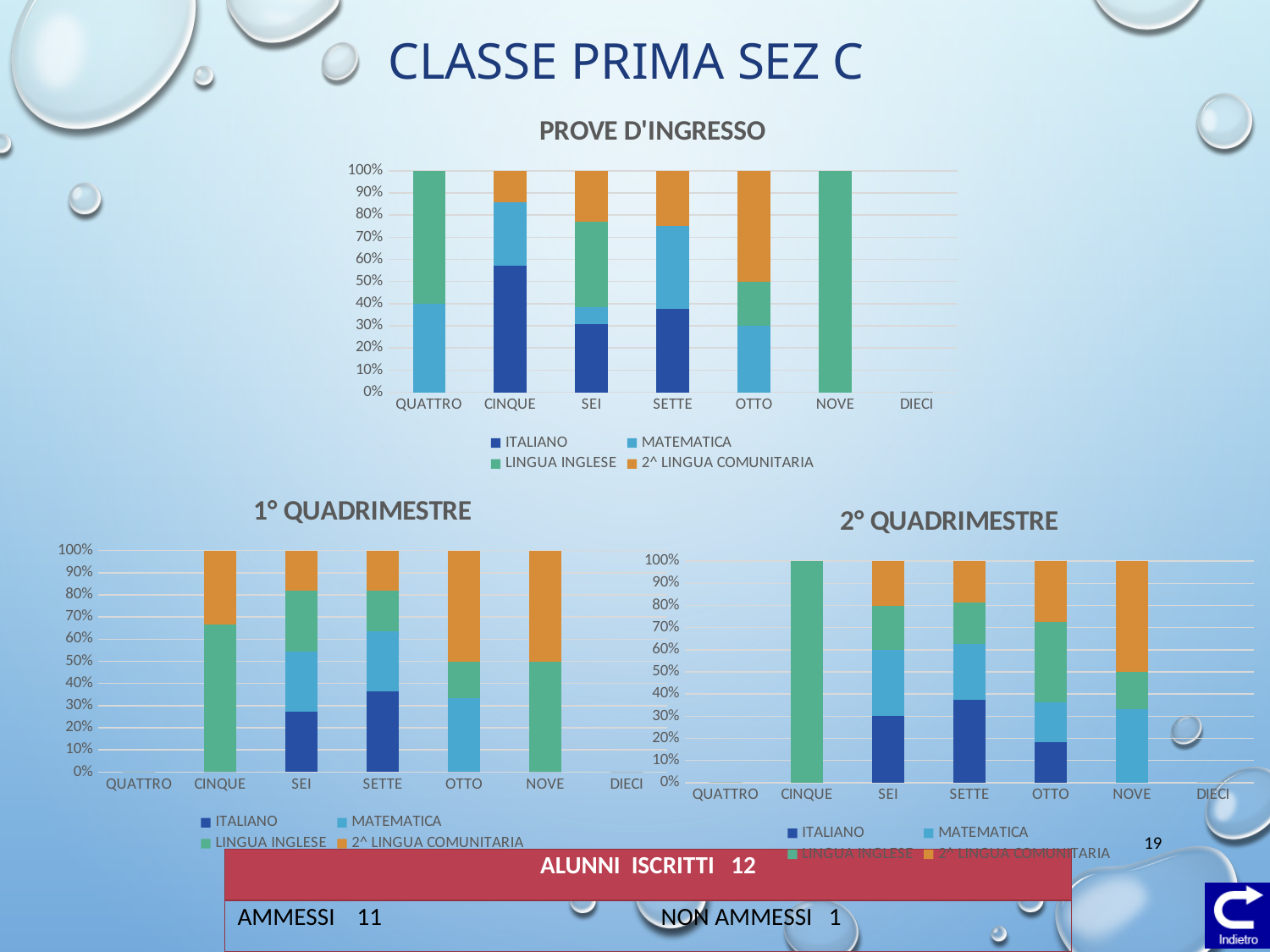
What is the title of the chart at the top of the slide? PROVE D'INGRESSO What kind of chart is the PROVE D'INGRESSO chart? stacked bar chart In the PROVE D'INGRESSO chart, is the ITALIANO segment for CINQUE greater or less than 50%? greater How many series does the legend of the PROVE D'INGRESSO chart list? 4 How many categories are shown on the x axis of the 1° QUADRIMESTRE chart? 7 In the PROVE D'INGRESSO chart, is the MATEMATICA segment for QUATTRO greater or less than 50%? less In the PROVE D'INGRESSO chart, is the ITALIANO segment for SEI greater or less than 40%? less Which series is shown in orange in the 2° QUADRIMESTRE chart's legend? 2^ LINGUA COMUNITARIA